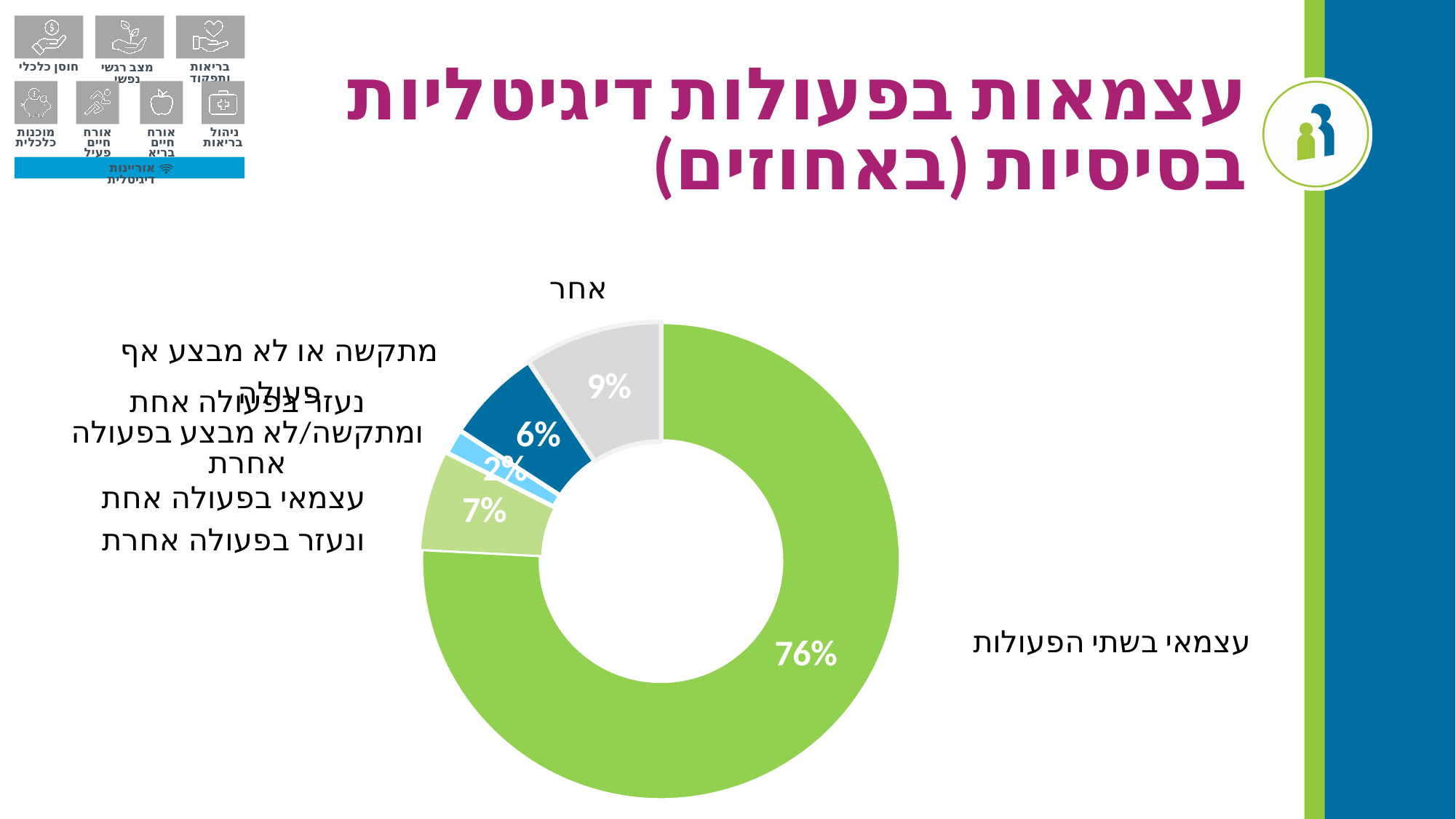
What is the value for "אחר"? 9% What is the value for "עצמאי בשתי הפעולות"? 76% What is the title of the slide containing the chart? עצמאות בפעולות דיגיטליות בסיסיות (באחוזים) What is the value for "מתקשה או לא מבצע אף פעולה"? 6% Which is larger: the share for "אחר" or the share for "עצמאי בפעולה אחת ונעזר בפעולה אחרת"? אחר Which category has the smallest share of the chart? נעזר בפעולה אחת ומתקשה/לא מבצע בפעולה אחרת How many slices does the chart have? 5 Which category has the largest share of the chart? עצמאי בשתי הפעולות What kind of chart is shown on the slide? Donut (pie) chart What is the value for "עצמאי בפעולה אחת ונעזר בפעולה אחרת"? 7% What is the value for "נעזר בפעולה אחת ומתקשה/לא מבצע בפעולה אחרת"? 2% What is the difference between the share for "עצמאי בשתי הפעולות" and the share for "אחר"? 67%